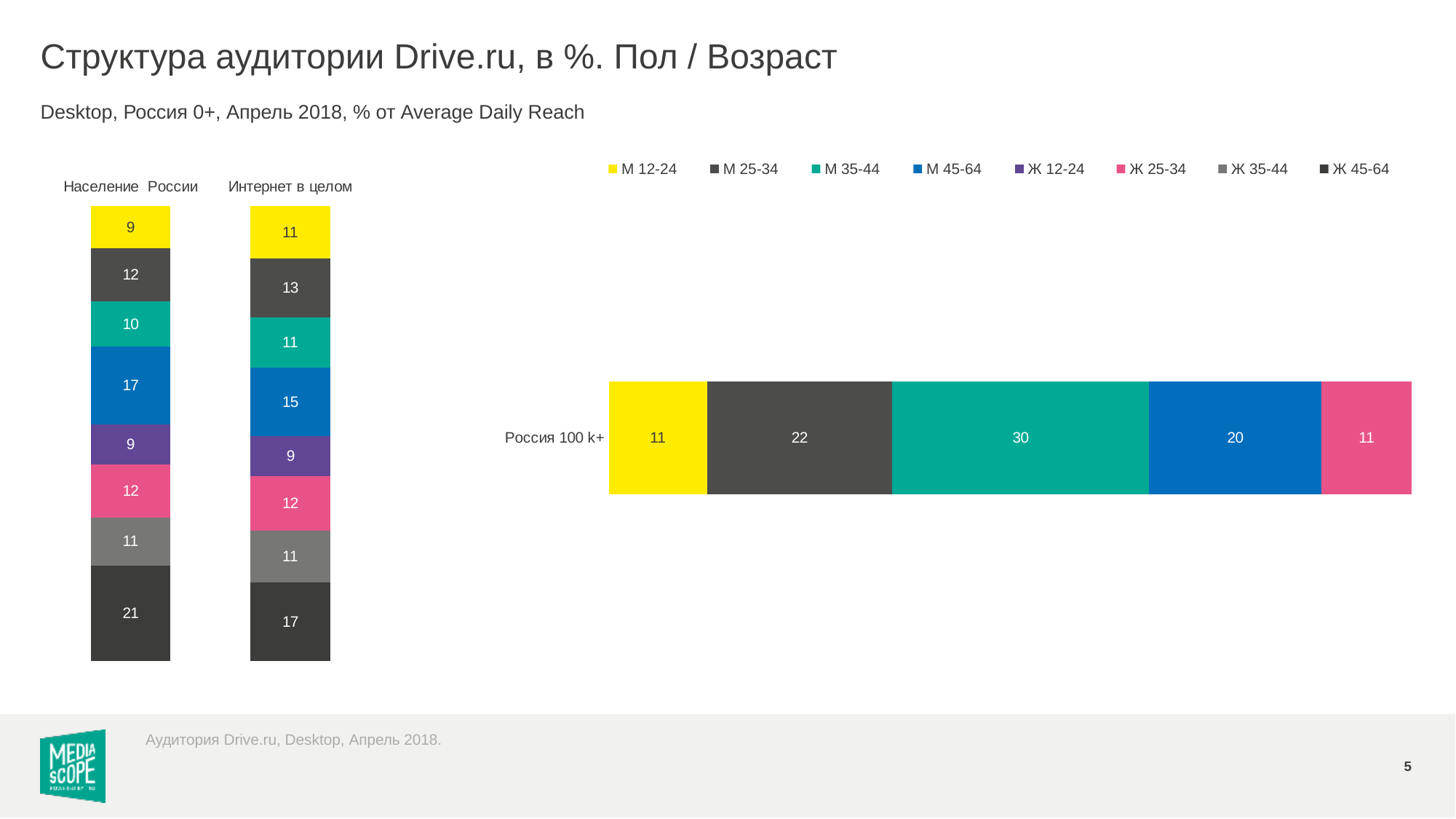
What kind of chart is the "Россия 100 k+" chart on the right? Stacked bar chart In the "Интернет в целом" bar, what is the value for Ж 45-64? 17 In the "Население России" bar, what is the value for M 45-64? 17 In the "Население России" bar, which series has the largest value? Ж 45-64 What is the total of the segments in the "Россия 100 k+" bar on the right? 94 What is the difference between the Ж 45-64 value in "Население России" and the Ж 45-64 value in "Интернет в целом"? 4 In the "Интернет в целом" bar, which series has the smallest value? Ж 12-24 In the "Россия 100 k+" bar on the right, what is the value for M 35-44? 30 How many segments are shown in the "Россия 100 k+" bar on the right? 5 In the "Россия 100 k+" bar on the right, which series has the largest segment? M 35-44 Which bar has the larger value for M 45-64: "Население России" or "Интернет в целом"? Население России How many series does the legend list? 8